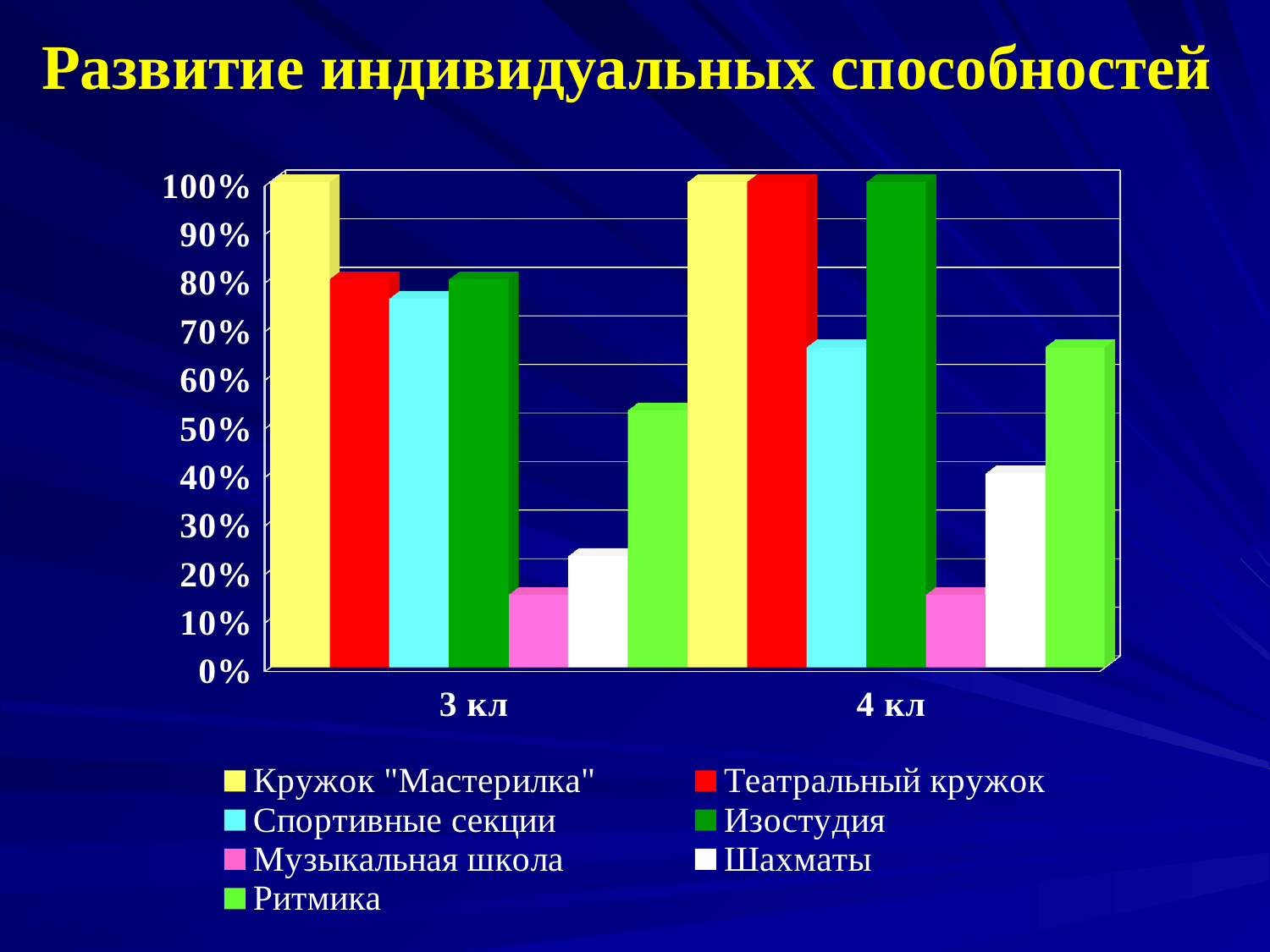
Which is larger in 3 кл: Ритмика or Шахматы? Ритмика Is the value for Шахматы in 3 кл greater or less than 30%? less Is the value for Музыкальная школа in 3 кл greater or less than 20%? less What is the value for Кружок "Мастерилка" in 3 кл? 100% How many categories are shown on the x axis? 2 What is the title of the chart? Развитие индивидуальных способностей Is the value for Ритмика in 4 кл greater or less than 60%? greater What kind of chart is shown on the slide? bar chart What is the value for Театральный кружок in 4 кл? 100% What is the value for Изостудия in 4 кл? 100% Which series has the lowest value in 4 кл? Музыкальная школа How many series does the legend list? 7